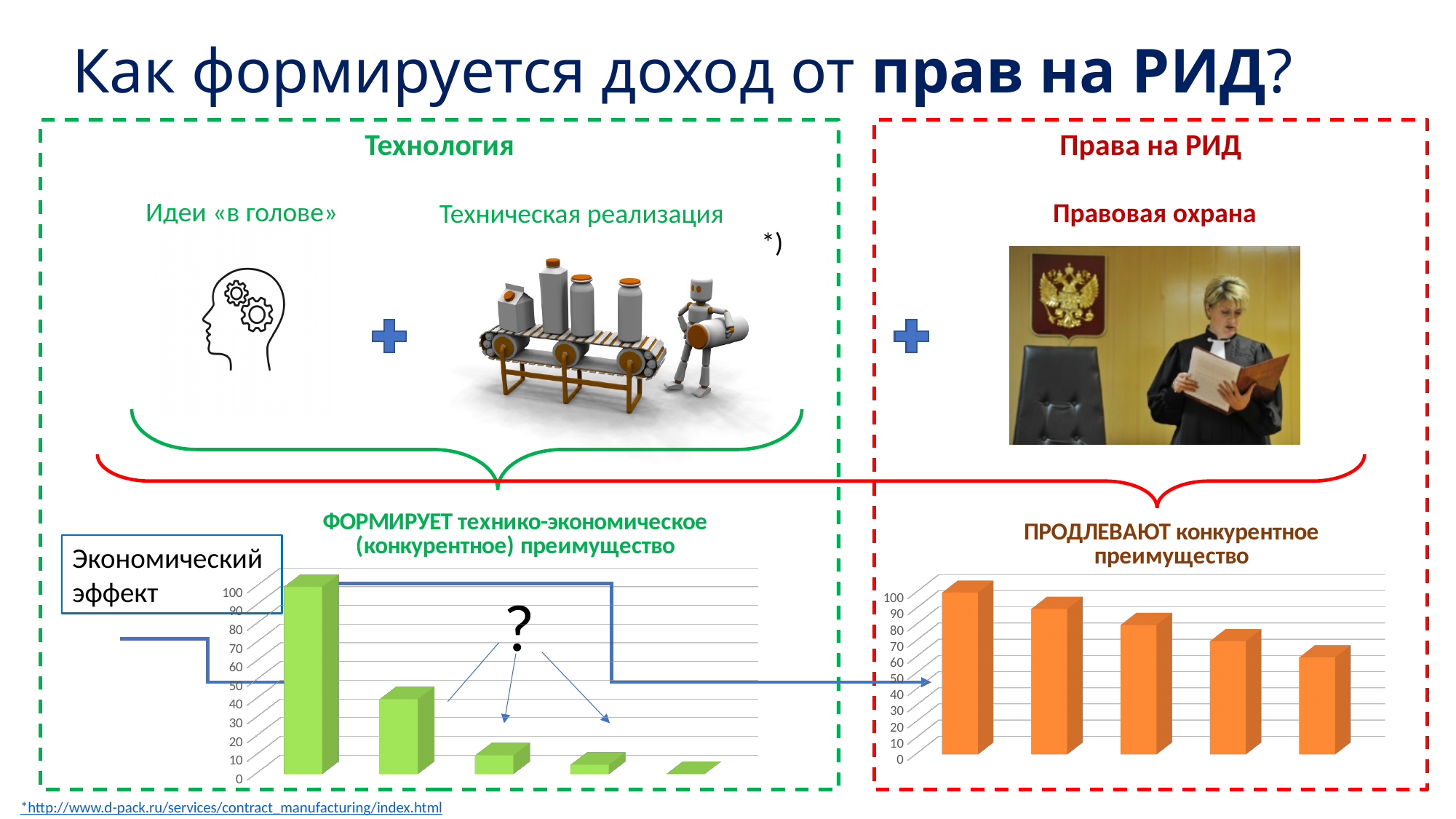
In the orange chart on the right, which bar is the tallest: the first or the last? the first In the orange chart on the right, is the value of the third bar greater or less than 90? less In the green chart on the left, is the value of the second bar greater or less than 50? less In the orange chart on the right, is the value of the last (rightmost) bar greater or less than 50? greater What kind of chart is the orange chart on the right side of the slide? bar chart In the green chart on the left, do the bar values rise or fall from left to right? fall What colour are the bars in the chart on the right side of the slide? orange How many bars does the green chart on the left side of the slide have? 5 How many bars does the orange chart on the right side of the slide have? 5 What kind of chart is the green chart on the left side of the slide? bar chart In the orange chart on the right, do the bar values rise or fall from left to right? fall